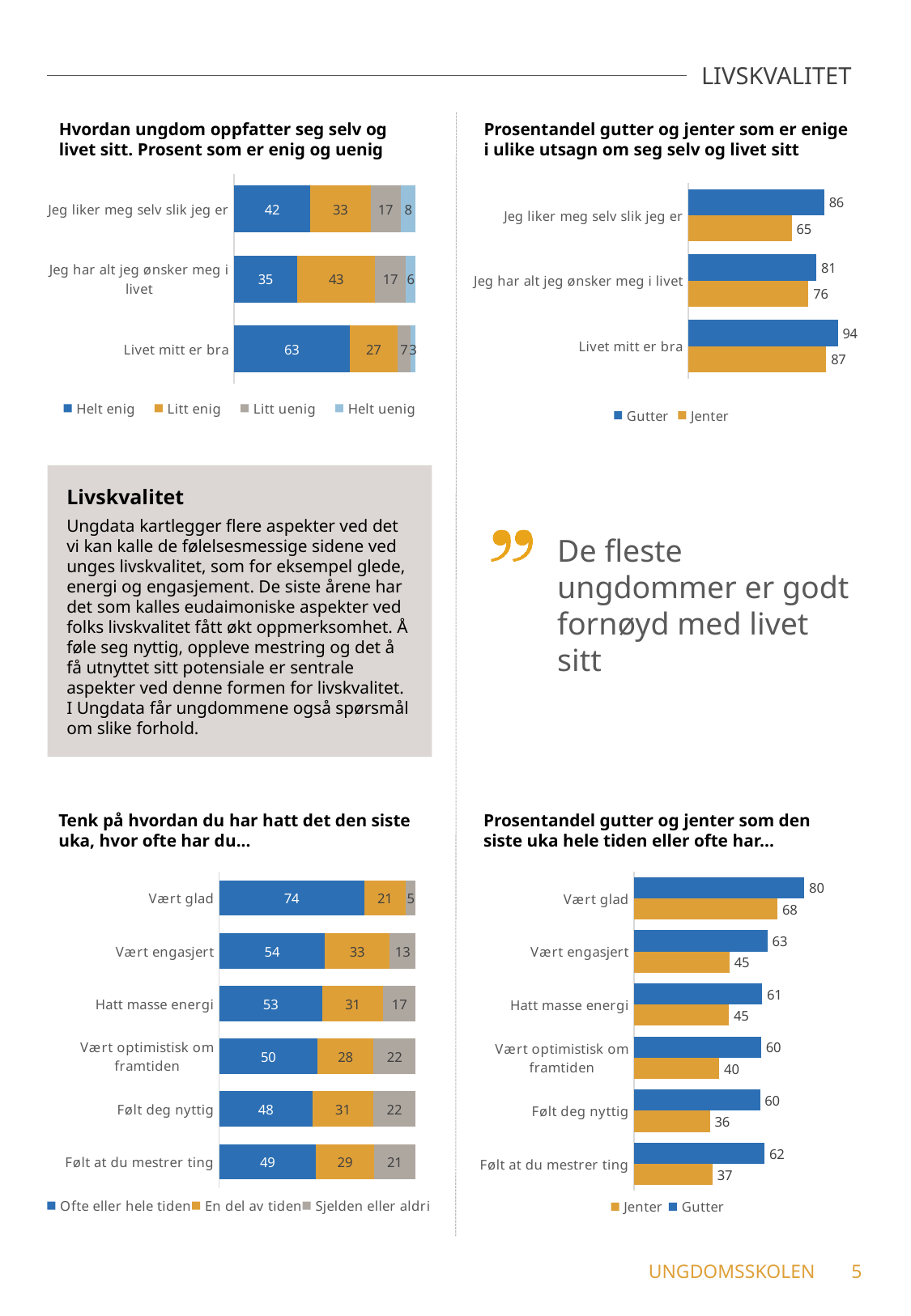
In the chart 'Tenk på hvordan du har hatt det den siste uka, hvor ofte har du…', which category has the lowest 'Sjelden eller aldri' value? Vært glad How many categories are shown in the chart 'Tenk på hvordan du har hatt det den siste uka, hvor ofte har du…'? 6 In the chart 'Prosentandel gutter og jenter som er enige i ulike utsagn om seg selv og livet sitt', what is the value for Jenter on 'Jeg har alt jeg ønsker meg i livet'? 76 In the chart 'Prosentandel gutter og jenter som er enige i ulike utsagn om seg selv og livet sitt', what is the difference between Gutter and Jenter for 'Jeg liker meg selv slik jeg er'? 21 In the chart 'Prosentandel gutter og jenter som den siste uka hele tiden eller ofte har…', what is the value for Jenter on 'Følt deg nyttig'? 36 How many series does the legend list in the chart 'Hvordan ungdom oppfatter seg selv og livet sitt'? 4 What kind of chart is 'Tenk på hvordan du har hatt det den siste uka, hvor ofte har du…'? Stacked bar chart In the chart 'Prosentandel gutter og jenter som er enige i ulike utsagn om seg selv og livet sitt', which statement has the highest Gutter value? Livet mitt er bra In the chart 'Hvordan ungdom oppfatter seg selv og livet sitt', what is the total of the stacked bar for 'Jeg liker meg selv slik jeg er'? 100 In the chart 'Prosentandel gutter og jenter som den siste uka hele tiden eller ofte har…', which is larger for 'Vært optimistisk om framtiden': Gutter or Jenter? Gutter In the chart 'Tenk på hvordan du har hatt det den siste uka, hvor ofte har du…', what is the 'En del av tiden' value for 'Vært engasjert'? 33 In the chart 'Hvordan ungdom oppfatter seg selv og livet sitt', what is the 'Helt enig' value for 'Livet mitt er bra'? 63